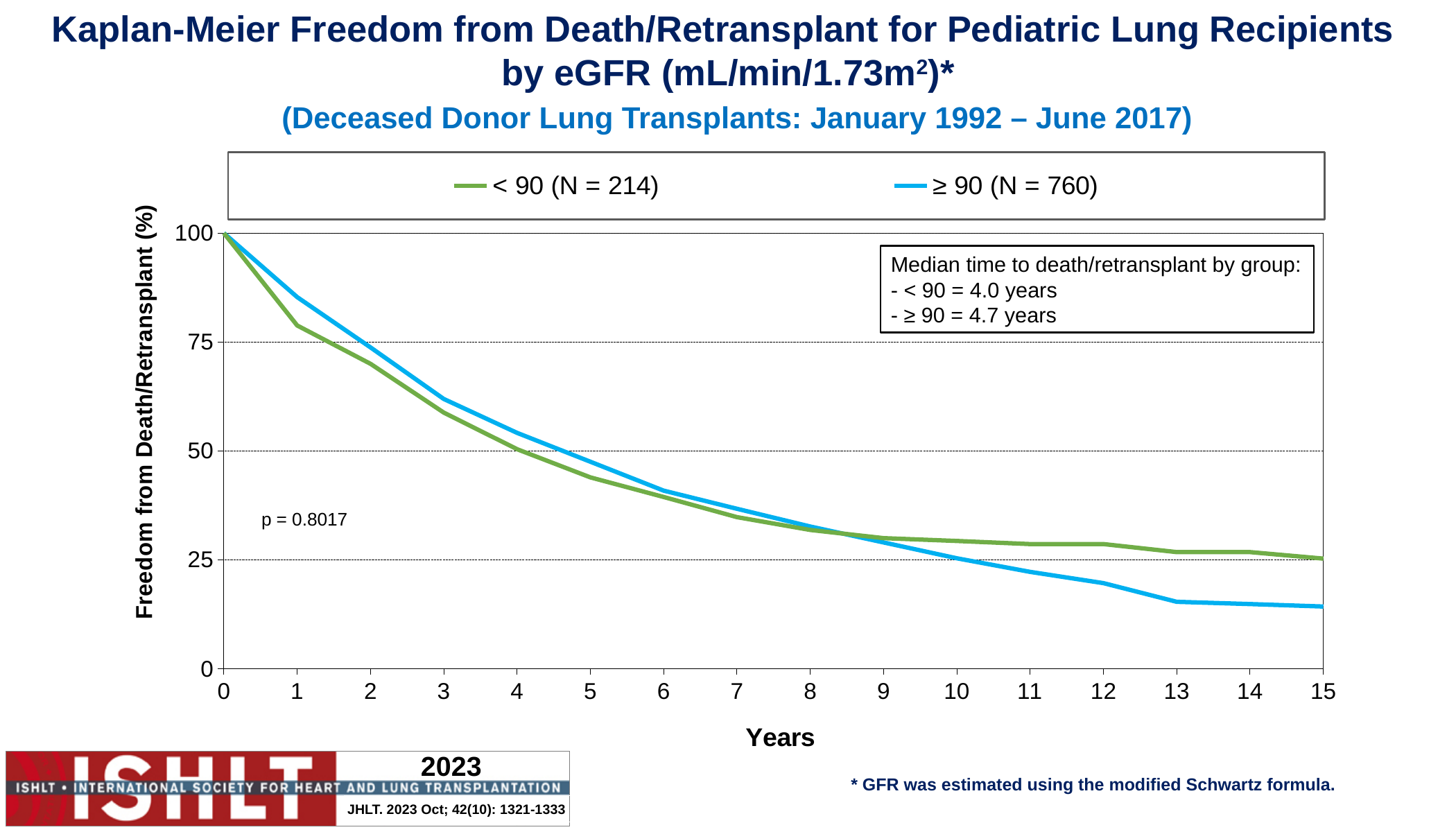
What kind of chart is shown on the slide? line chart What is the median time to death/retransplant for the ≥ 90 group? 4.7 years What is the freedom from death/retransplant for the ≥ 90 group at year 0? 100 Is the value for the ≥ 90 group at year 3 greater or less than 50? greater What p-value is printed on the chart? p = 0.8017 What is the N for the < 90 eGFR group shown in the legend? 214 What is the median time to death/retransplant for the < 90 group? 4.0 years How many series does the legend list? 2 At year 13, which group has the higher freedom from death/retransplant, < 90 or ≥ 90? < 90 Is the value for the < 90 group at year 5 greater or less than 50? less Is the value for the ≥ 90 group at year 15 greater or less than 25? less What is the N for the ≥ 90 eGFR group shown in the legend? 760